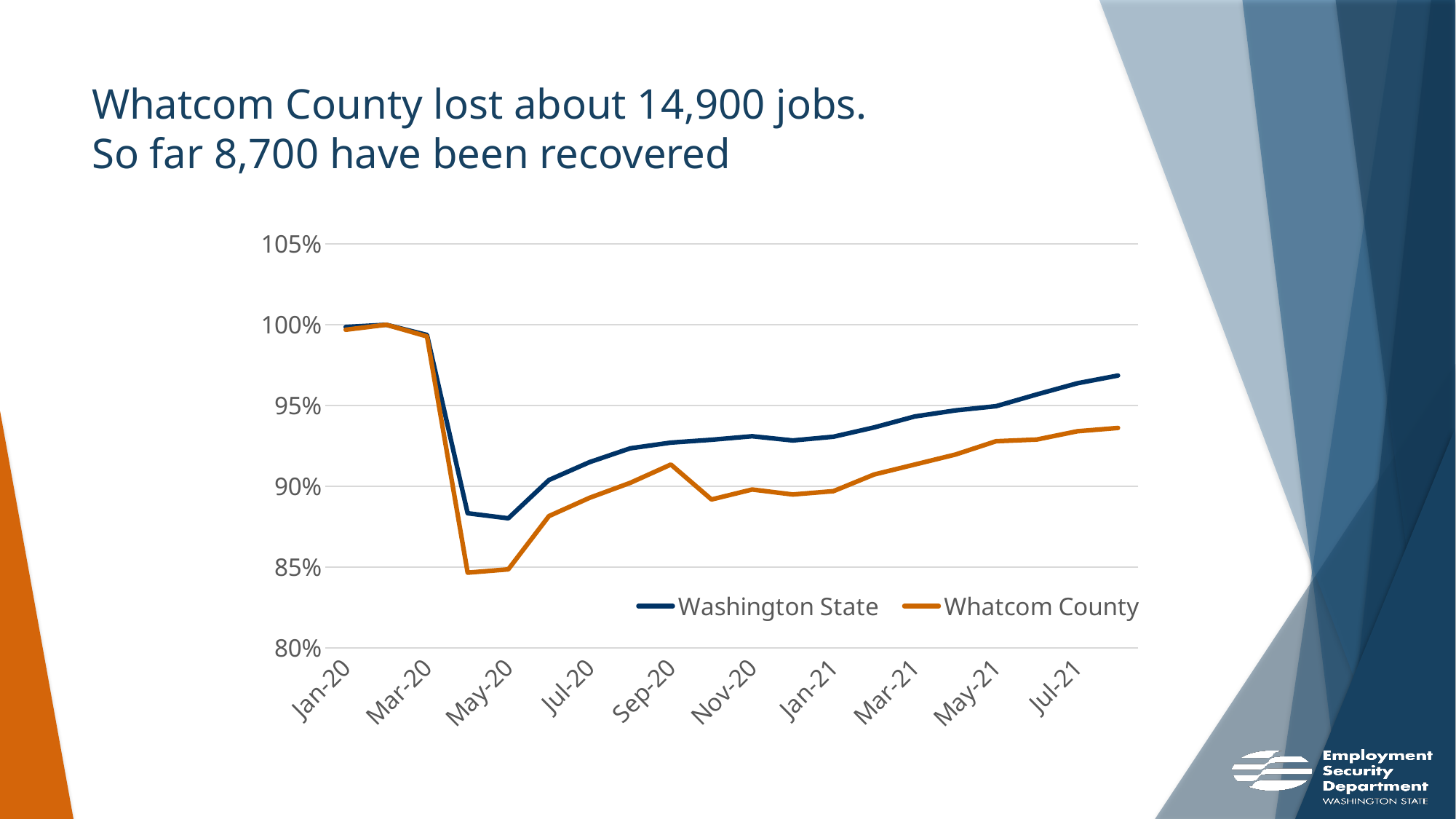
Which two series are listed in the chart's legend? Washington State and Whatcom County Is the value for Whatcom County at Sep-20 greater or less than 90%? greater What colour is the Whatcom County line in the chart? Orange At May-20, which series has the lower value, Washington State or Whatcom County? Whatcom County How many month labels are shown on the x axis of the chart? 10 Is the value for Washington State at May-20 greater or less than 90%? less At Jul-21, which series has the higher value, Washington State or Whatcom County? Washington State What kind of chart is shown on the slide? Line chart How many series does the chart's legend list? 2 From May-20 to Jul-21, does the Washington State line generally rise or fall? Rise Is the value for Washington State at Jul-21 greater or less than 95%? greater